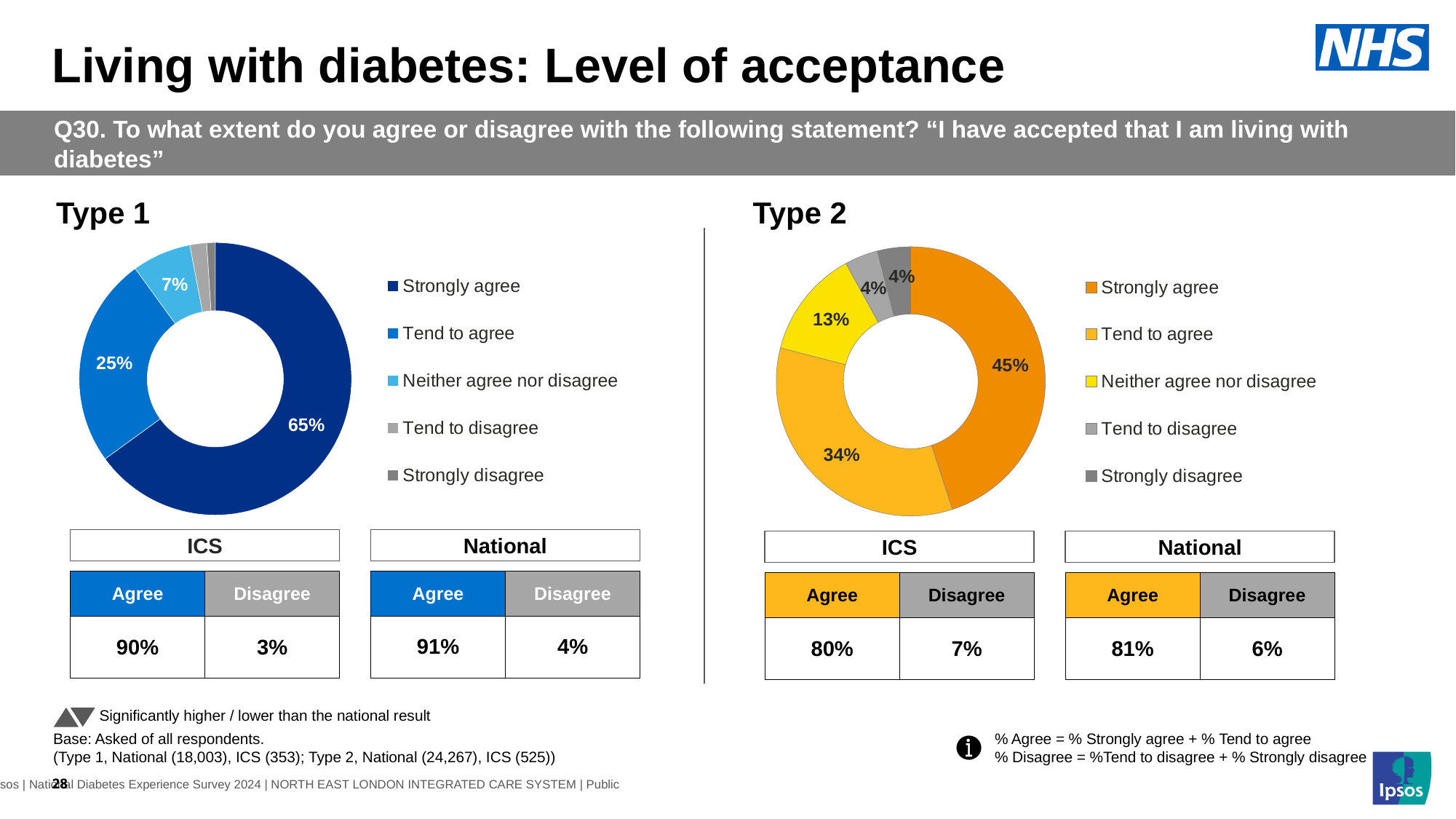
In the Type 1 chart, which category has the largest share? Strongly agree In the Type 2 chart, what percentage of respondents tend to agree? 34% In the Type 2 chart, what percentage neither agree nor disagree? 13% In the Type 1 chart, what percentage of respondents tend to agree? 25% In the Type 1 chart, what is the difference between the Strongly agree and Tend to agree shares? 40% Which chart has a larger Strongly agree share, Type 1 or Type 2? Type 1 In the Type 1 chart, what percentage of respondents strongly agree? 65% In the Type 1 chart, what percentage neither agree nor disagree? 7% How many categories does the legend of the Type 2 chart list? 5 In the Type 2 chart, what is the difference between the Strongly agree and Tend to agree shares? 11% In the Type 2 chart, which category has the largest share? Strongly agree In the Type 2 chart, what percentage of respondents strongly agree? 45%